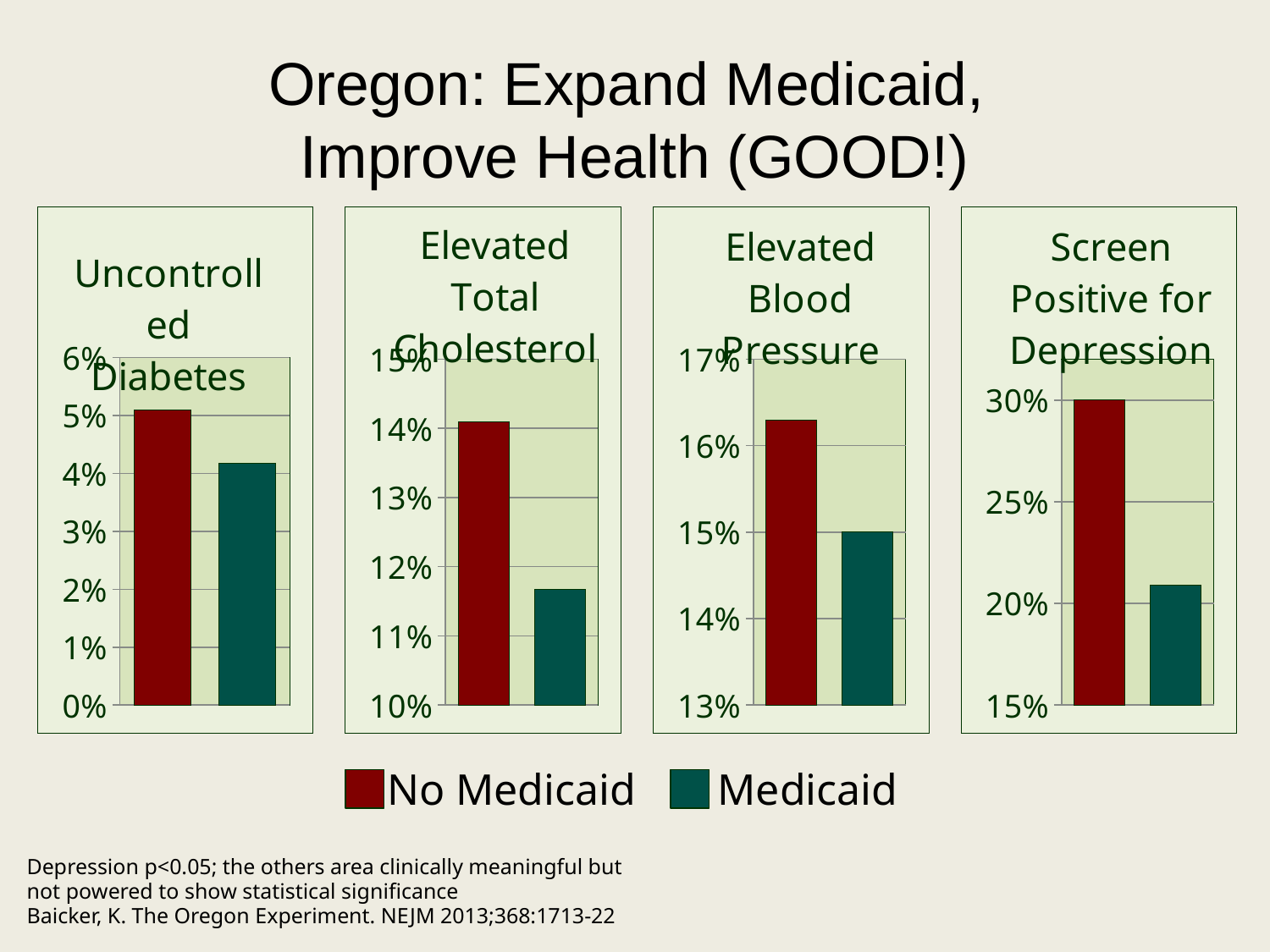
In the 'Screen Positive for Depression' chart, is the value for No Medicaid greater or less than 25%? greater How many bars are plotted in the 'Screen Positive for Depression' chart? 2 In the 'Uncontrolled Diabetes' chart, which bar is taller, No Medicaid or Medicaid? No Medicaid What are the two series named in the legend? No Medicaid, Medicaid In the 'Elevated Blood Pressure' chart, which group has the lower value? Medicaid In the 'Elevated Total Cholesterol' chart, which group has the higher value? No Medicaid What kind of chart is used in the 'Uncontrolled Diabetes' panel? bar chart How many series does the legend list? 2 In the 'Elevated Total Cholesterol' chart, is the value for Medicaid greater or less than 12%? less In the 'Screen Positive for Depression' chart, is the value for Medicaid greater or less than 25%? less